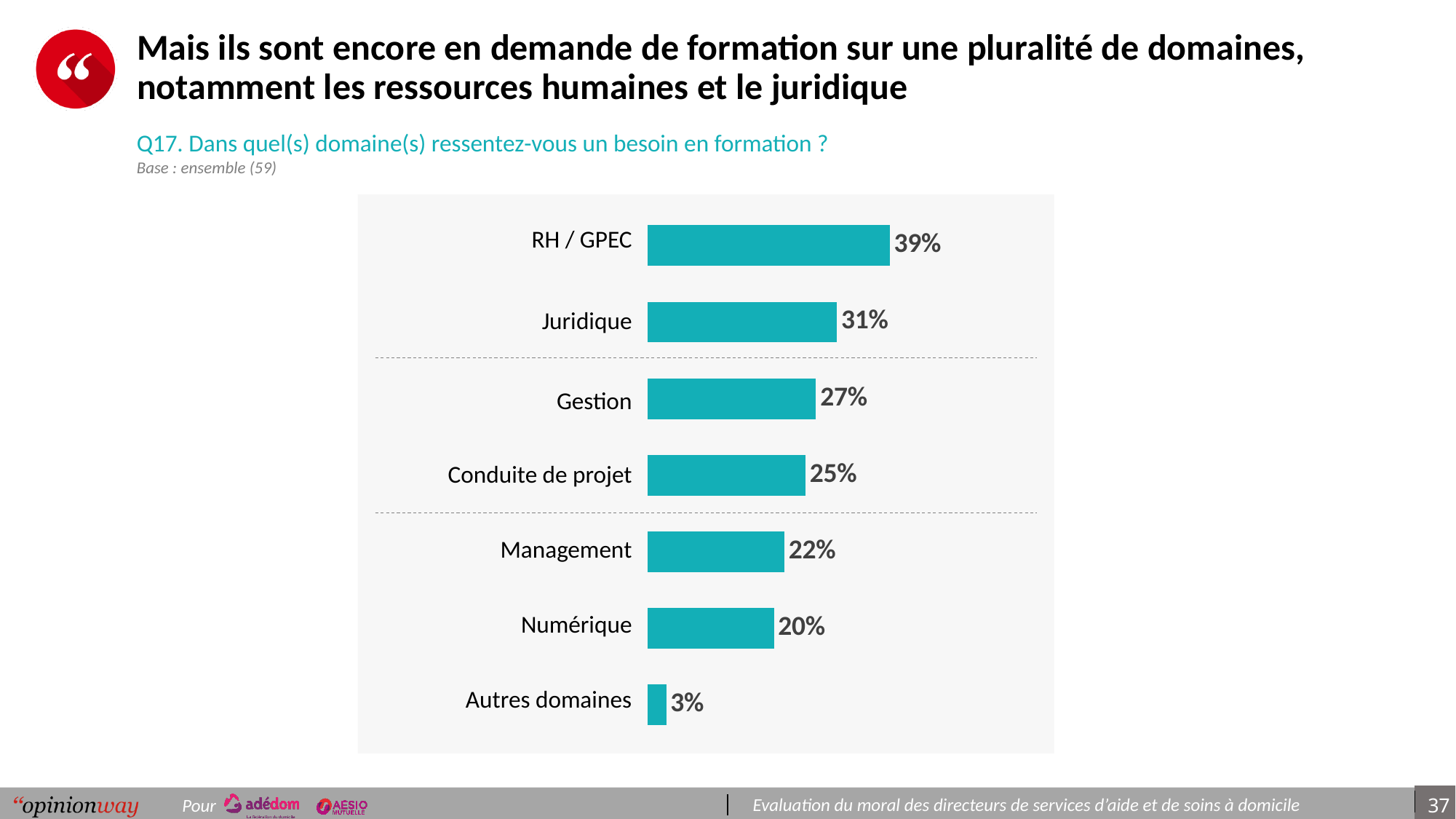
Which is larger, the value for Management or the value for Numérique? Management Which category has the lowest value? Autres domaines Which category has the highest value? RH / GPEC What is the difference between the values for RH / GPEC and Juridique? 8% What is the value for Numérique? 20% What is the value for Conduite de projet? 25% What is the base (number of respondents) indicated for the chart? 59 What kind of chart is shown on the slide? Bar chart What is the difference between the values for Gestion and Management? 5% What is the value for Juridique? 31% How many categories are shown in the chart? 7 What is the value for RH / GPEC? 39%